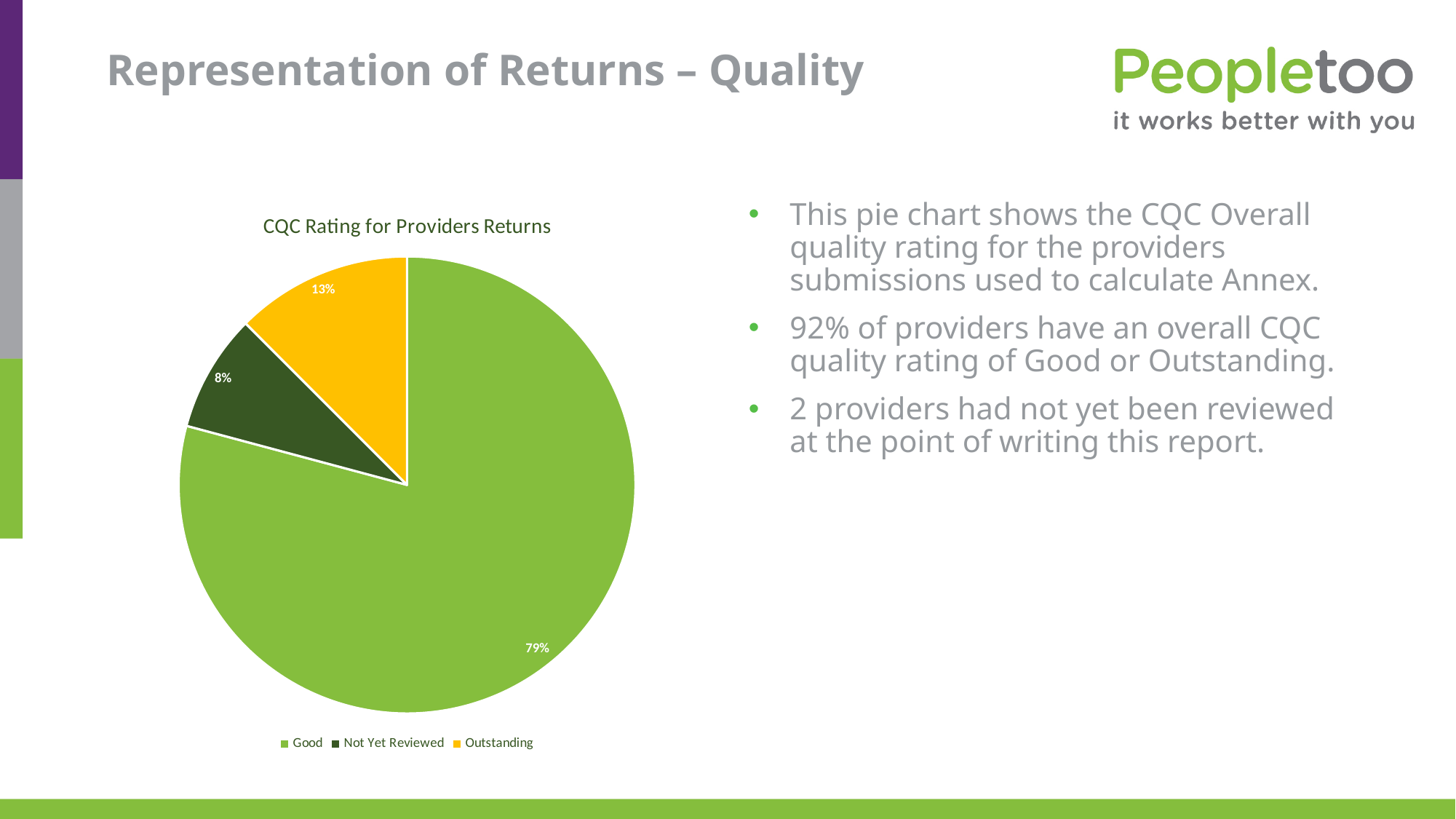
Which category has the smallest share of the pie? Not Yet Reviewed What percentage of the pie is labelled Not Yet Reviewed? 8% What percentage of the pie is labelled Good? 79% How many categories does the pie chart show? 3 What is the title of the chart? CQC Rating for Providers Returns What colour is the Outstanding slice? Yellow Which category has the largest share of the pie? Good What percentage of the pie is labelled Outstanding? 13% What type of chart is shown on the slide? Pie chart Which slice is larger, Outstanding or Not Yet Reviewed? Outstanding What is the difference in percentage points between the Good and Outstanding slices? 66 How many entries does the legend list? 3